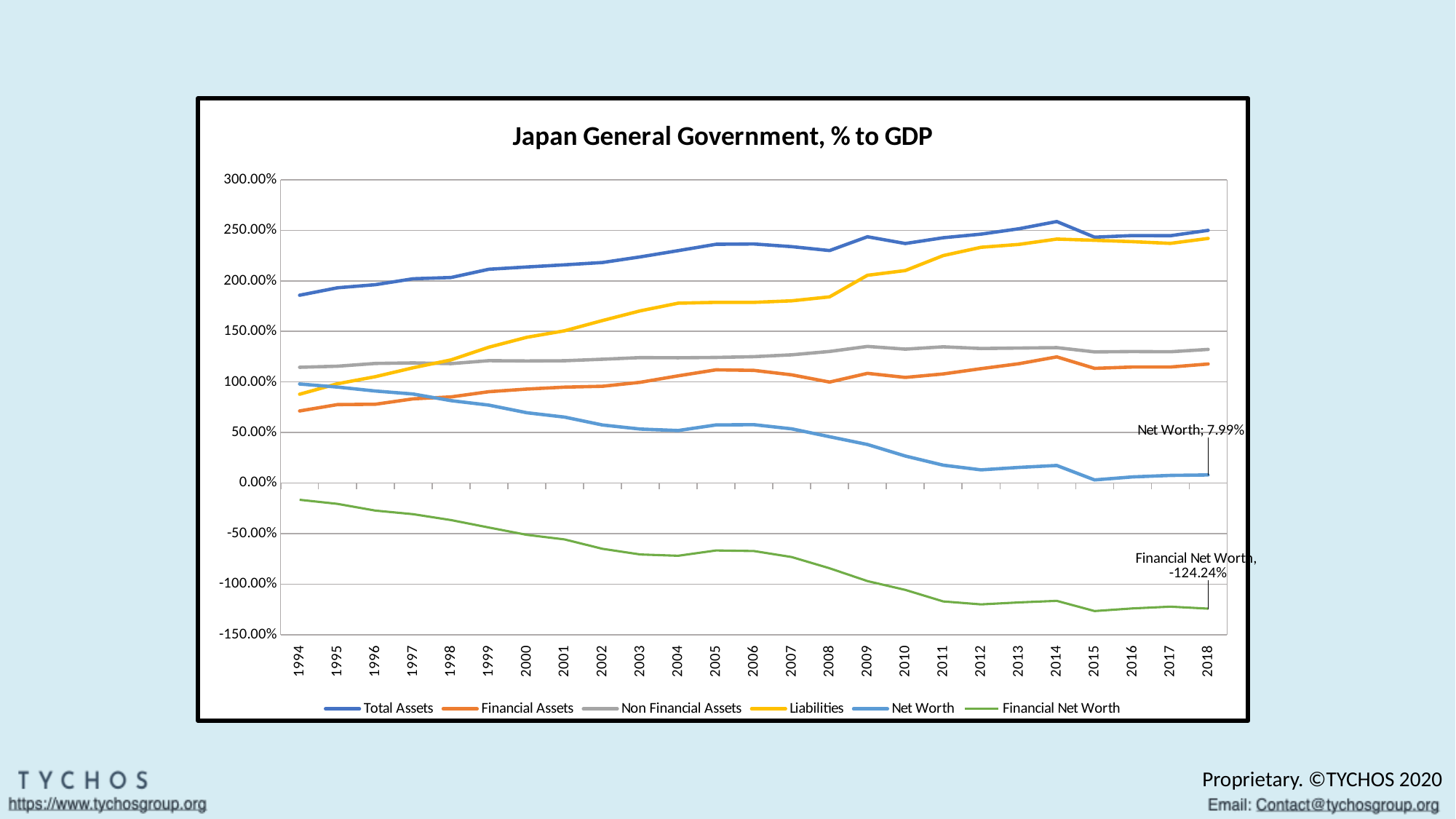
What is the value of Financial Net Worth in 2018? -124.24% How many series does the legend list? 6 In 2018, which is larger: Total Assets or Non Financial Assets? Total Assets Which series has the lowest value in 2018? Financial Net Worth Does the Net Worth series rise or fall from 1994 to 2018? Fall Does the Liabilities series rise or fall from 1994 to 2018? Rise What is the title of the chart? Japan General Government, % to GDP Is the value for Liabilities in 1994 greater or less than 100.00%? less How many years are plotted along the x axis? 25 What kind of chart is shown on the slide? Line chart Is the value for Total Assets in 1994 greater or less than 150.00%? greater What is the value of Net Worth in 2018? 7.99%